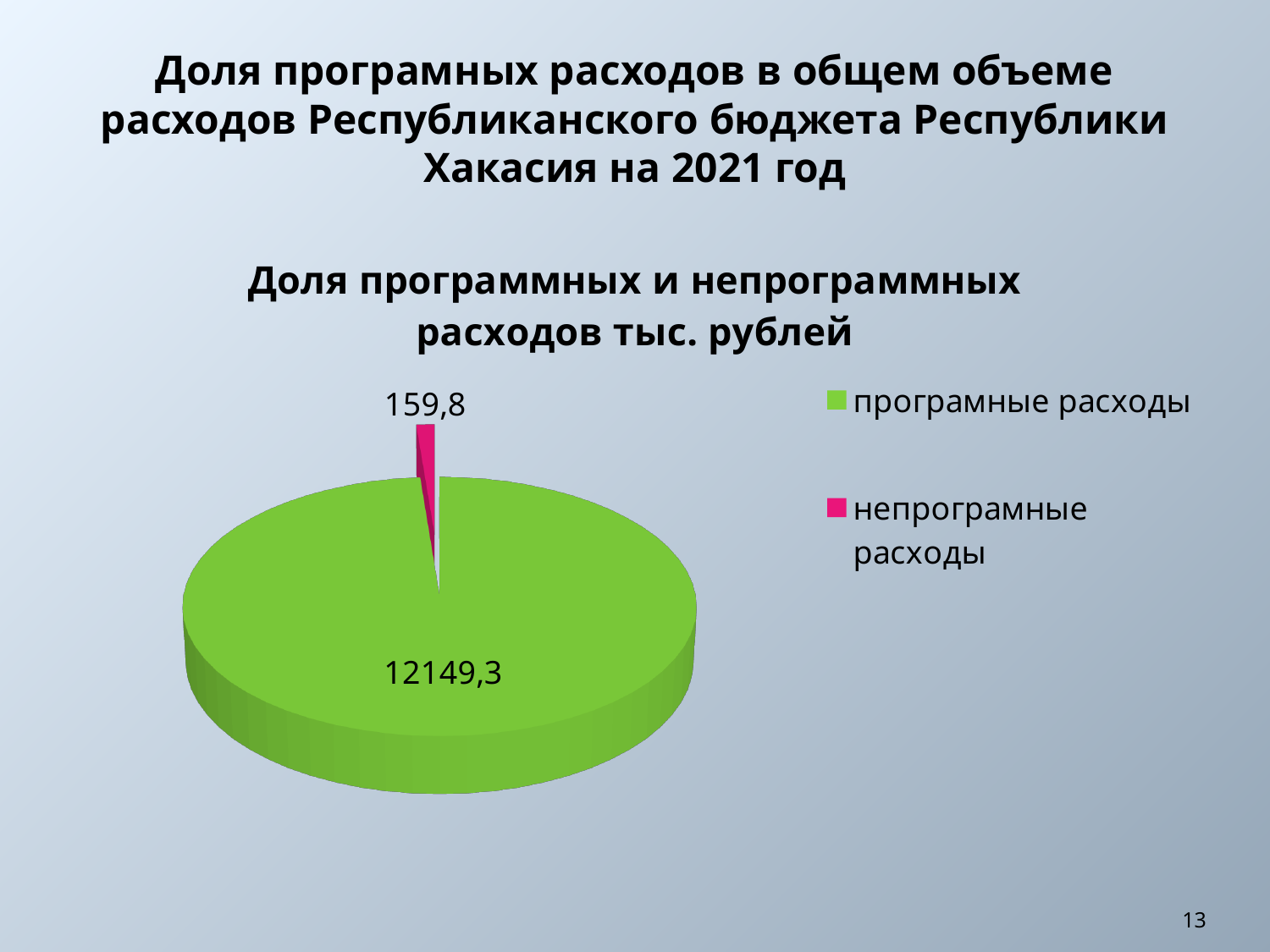
What is the value for непрограмные расходы? 159,8 What is the difference between програмные расходы and непрограмные расходы? 11989,5 Which category has the largest slice of the pie? програмные расходы Which is larger, програмные расходы or непрограмные расходы? програмные расходы What is the total of the two values shown in the pie chart? 12309,1 What is the value for програмные расходы? 12149,3 What type of chart is shown on the slide? pie chart How many entries does the legend list? 2 What colour is the slice for непрограмные расходы? pink Which category has the smallest slice of the pie? непрограмные расходы What is the title of the chart? Доля программных и непрограммных расходов тыс. рублей How many slices does the pie chart have? 2